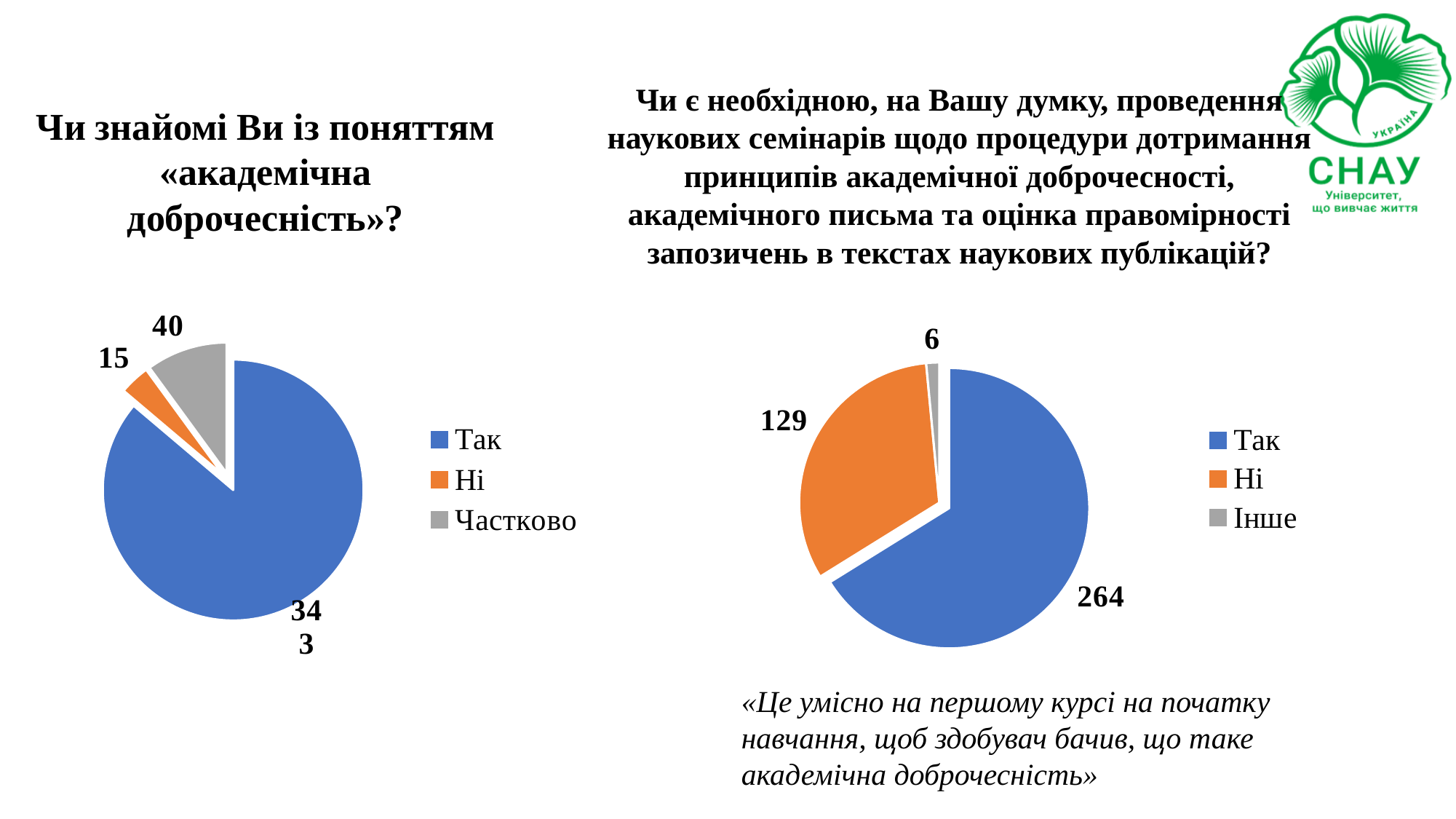
In the right pie chart, what is the value for Ні? 129 How many categories does the legend of the right pie chart list? 3 In the right pie chart, which category has the smallest value? Інше What type of chart is used on the left side of the slide? Pie chart In the left pie chart, what is the value for Так? 343 In the left pie chart, which is larger: Частково or Ні? Частково In the right pie chart, what is the value for Інше? 6 In the left pie chart ("Чи знайомі Ви із поняттям «академічна доброчесність»?"), what is the value for Частково? 40 In the right pie chart (about scientific seminars on academic integrity), what is the value for Так? 264 In the left pie chart, what is the value for Ні? 15 In the right pie chart, what is the difference between the values for Так and Ні? 135 In the left pie chart, which category has the largest value? Так